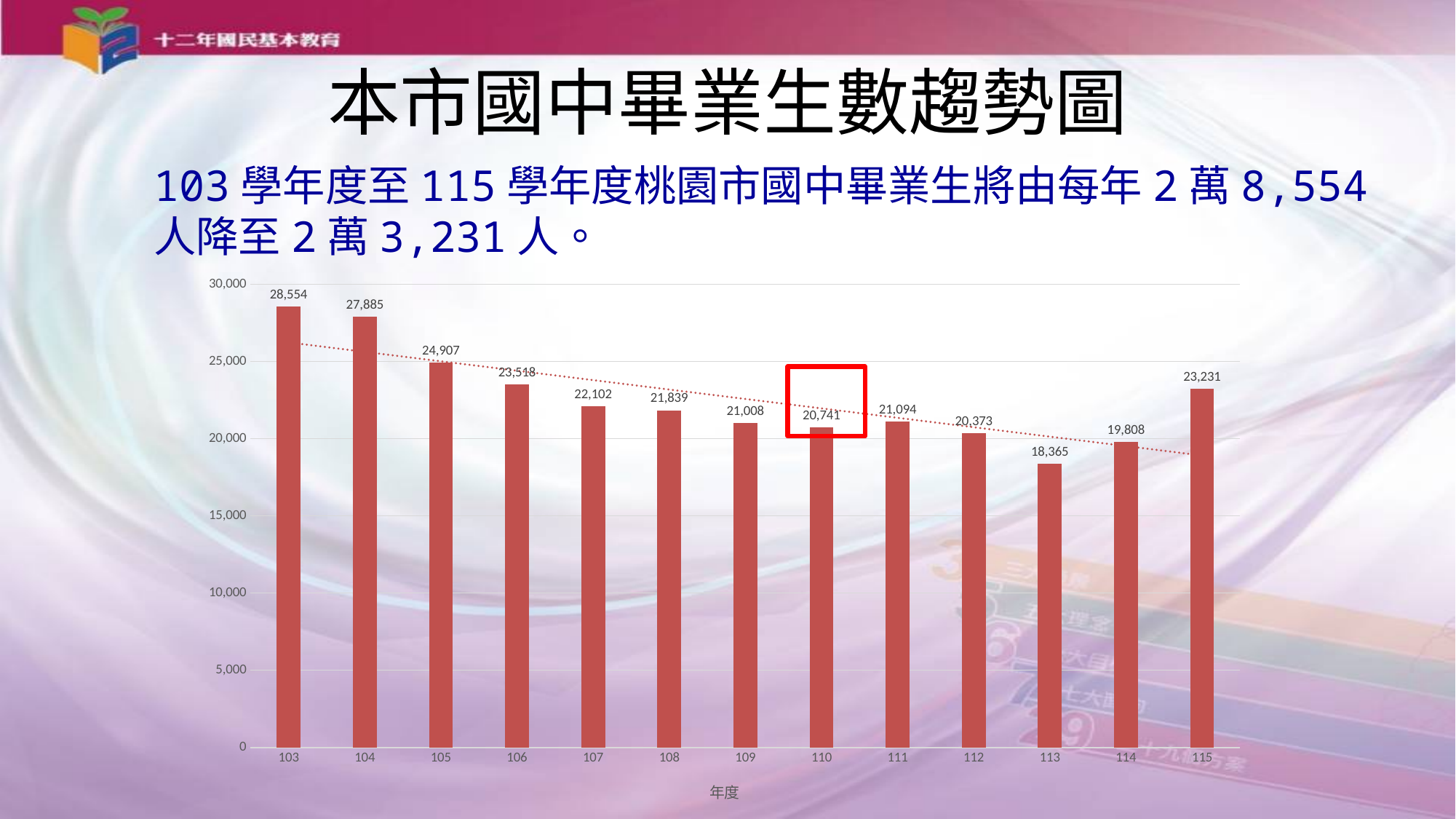
Which year has the lowest value? 113 What is the value for year 103? 28,554 What kind of chart is this? bar chart Which is larger, the value for year 111 or the value for year 112? 111 How many years are shown on the x axis? 13 What is the value for year 110? 20,741 What is the label of the x axis? 年度 What is the value for year 115? 23,231 Is the value for year 113 greater or less than 20,000? less What is the difference between the values for year 103 and year 115? 5,323 Which year has the highest value? 103 Do the values generally rise or fall from year 103 to year 113? fall